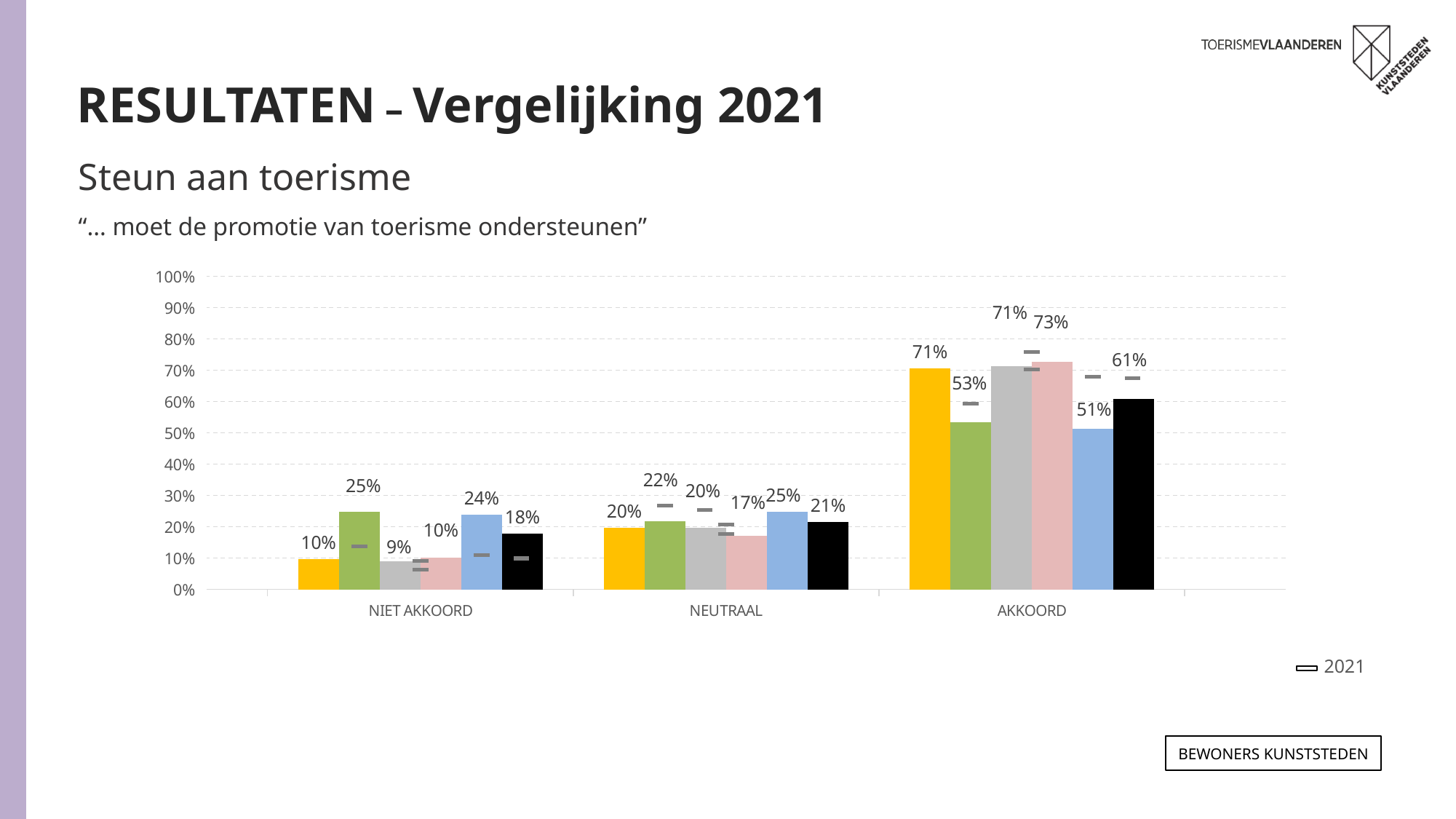
Is the 2021 marker above the yellow bar in the AKKOORD category greater or less than 60%? greater What is the value of the black bar in the AKKOORD category? 61% What is the difference between the pink bar and the blue bar in the AKKOORD category? 22 percentage points What is the value of the green bar in the NIET AKKOORD category? 25% What entry does the chart legend list? 2021 What kind of chart is shown on the slide? Bar chart What is the value of the yellow bar in the AKKOORD category? 71% Which bar has the lowest value in the NIET AKKOORD category? The grey bar (9%) In the AKKOORD category, which is larger: the yellow bar or the green bar? The yellow bar (71%) Which bar has the highest value in the AKKOORD category? The pink bar (73%) How many categories are shown on the x axis? 3 What is the value of the pink bar in the NEUTRAAL category? 17%